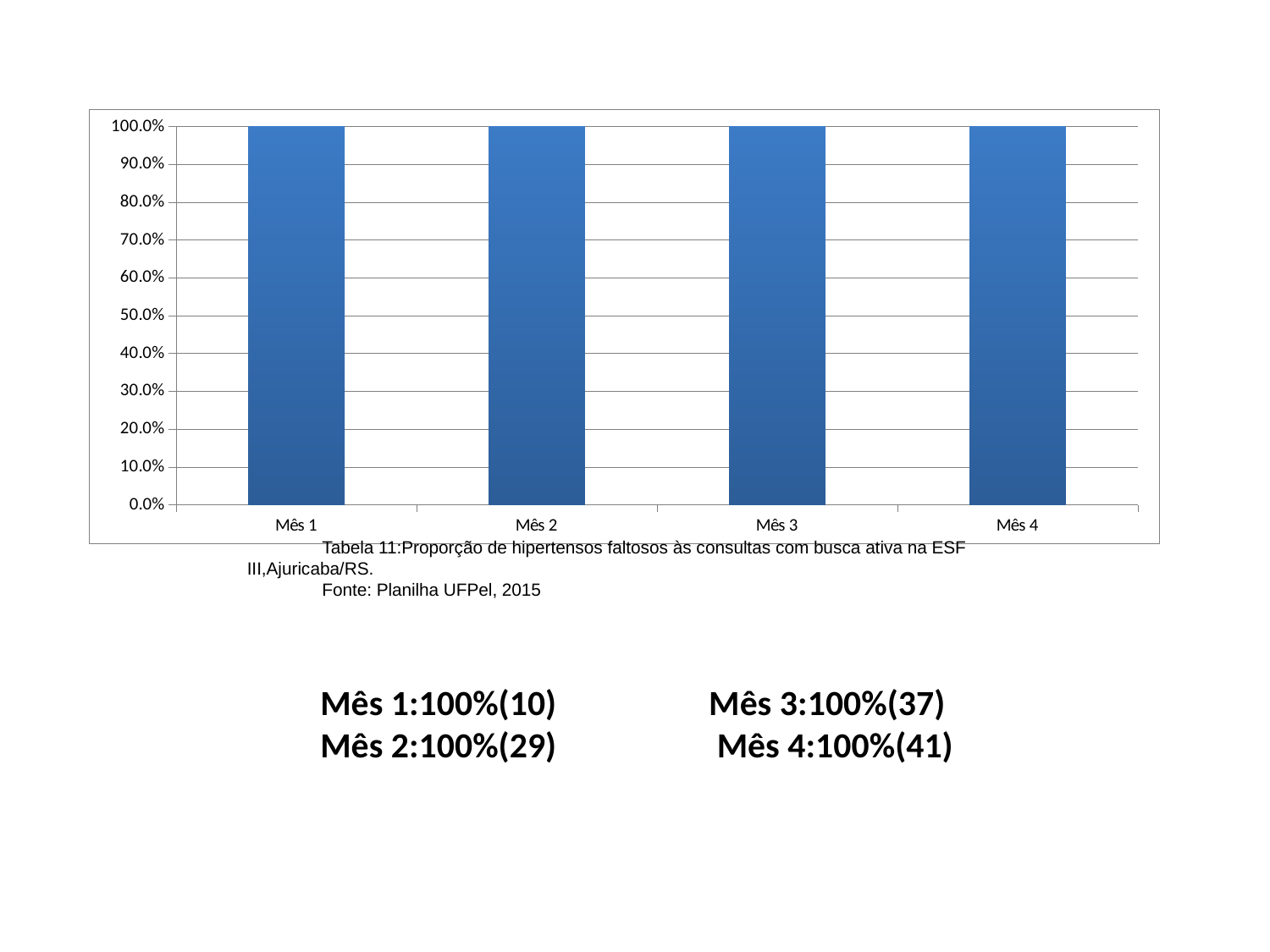
According to the caption, what is the source of the chart data? Planilha UFPel, 2015 What kind of chart is shown on the slide? bar chart What is the value for Mês 3? 100% What is the value for Mês 1? 100% What is the value for Mês 2? 100% Is the value for Mês 3 greater or less than 50.0%? greater How many categories (months) are plotted on the chart? 4 What is the difference between the values for Mês 1 and Mês 4? 0% Do the values rise, fall, or stay the same from Mês 1 to Mês 4? stay the same What is the value for Mês 4? 100% What is the highest value shown on the vertical axis? 100.0%